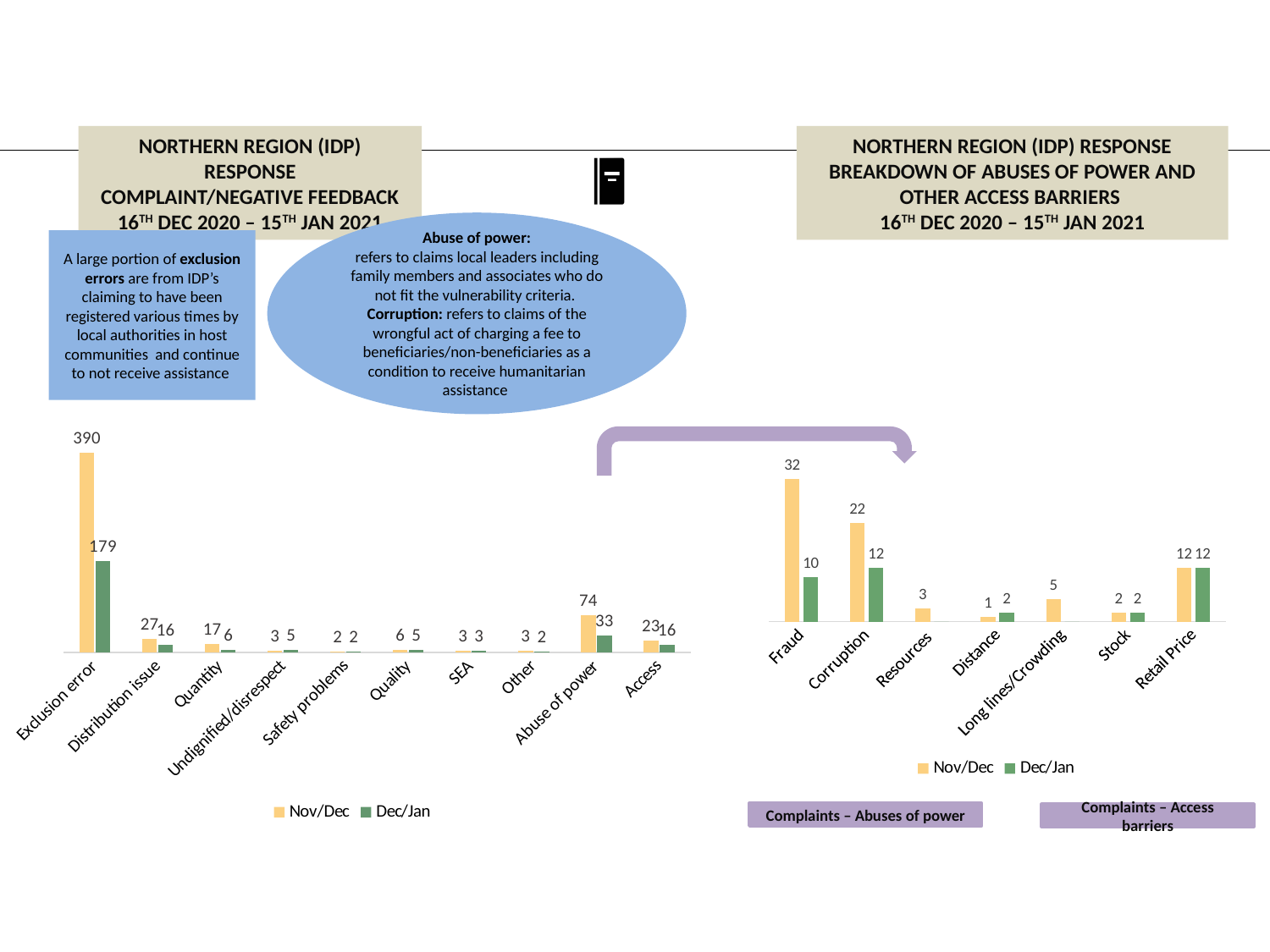
On the right chart (Breakdown of Abuses of Power and Other Access Barriers), which category has the lowest Nov/Dec value? Distance What kind of chart is the right chart (Breakdown of Abuses of Power and Other Access Barriers)? Bar chart On the left chart (Complaint/Negative Feedback), which category has the highest Nov/Dec value? Exclusion error On the right chart (Breakdown of Abuses of Power and Other Access Barriers), what is the Dec/Jan value for Corruption? 12 On the left chart (Complaint/Negative Feedback), which is larger: the Nov/Dec value for Distribution issue or the Nov/Dec value for Access? Distribution issue On the right chart (Breakdown of Abuses of Power and Other Access Barriers), how many series does the legend list? 2 On the left chart (Complaint/Negative Feedback), what is the Dec/Jan value for Abuse of power? 33 On the right chart (Breakdown of Abuses of Power and Other Access Barriers), what is the difference between the Nov/Dec and Dec/Jan values for Fraud? 22 On the left chart (Complaint/Negative Feedback), what is the Nov/Dec value for Exclusion error? 390 On the left chart (Complaint/Negative Feedback), how many categories are shown on the x axis? 10 On the right chart (Breakdown of Abuses of Power and Other Access Barriers), what is the Nov/Dec value for Fraud? 32 On the left chart (Complaint/Negative Feedback), what is the difference between the Nov/Dec and Dec/Jan values for Exclusion error? 211